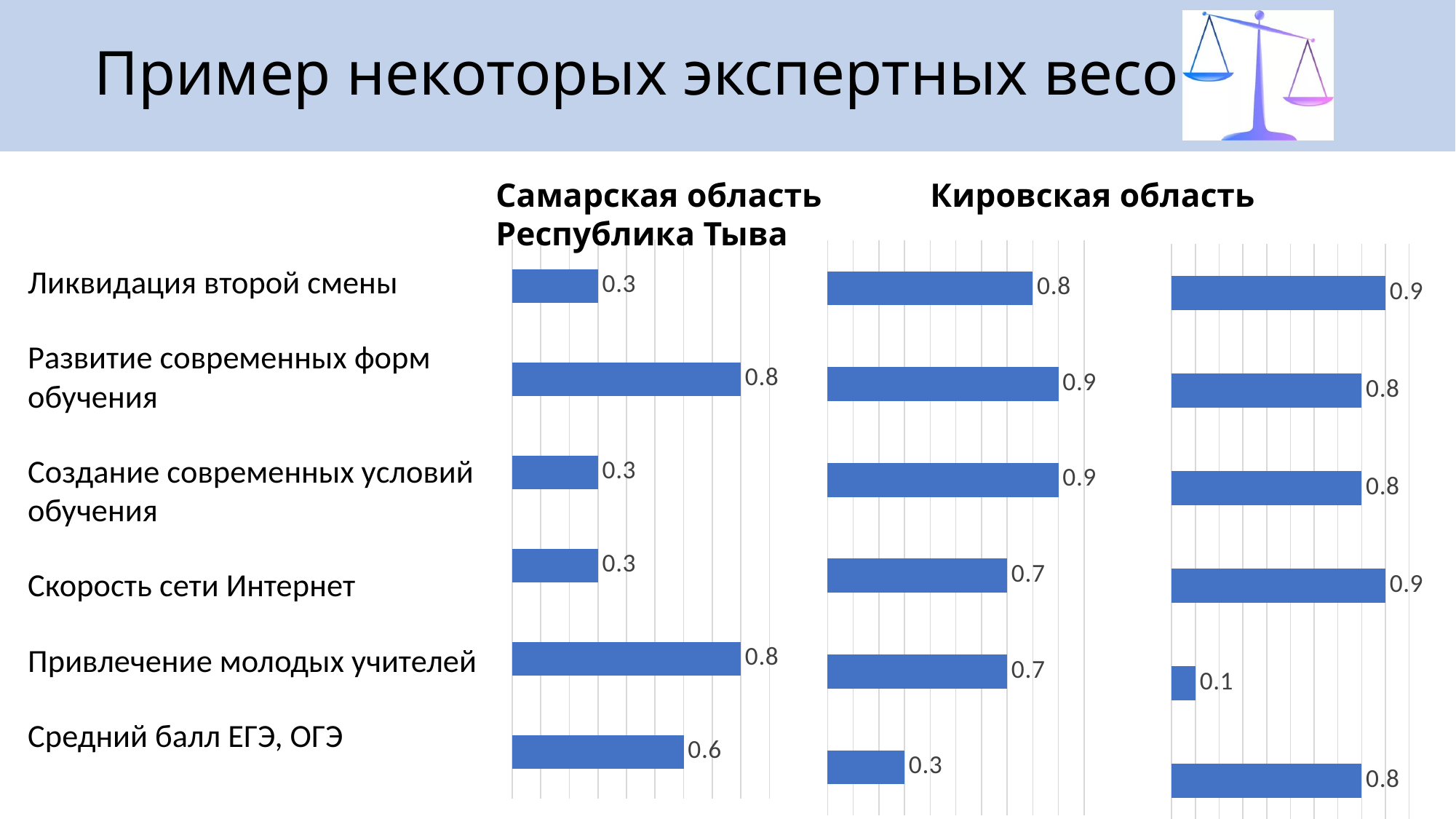
In the middle chart, which category has the lowest value? Средний балл ЕГЭ, ОГЭ How many categories are plotted in the left chart? 6 In the middle chart, what is the difference between the values for Ликвидация второй смены and Средний балл ЕГЭ, ОГЭ? 0.5 What is the heading printed above the middle chart? Кировская область In the right chart, what is the value for Привлечение молодых учителей? 0.1 What type of chart is the middle chart? bar chart In the left chart, what is the value for Ликвидация второй смены? 0.3 In the right chart, which category has the lowest value? Привлечение молодых учителей In the middle chart, what is the value for Скорость сети Интернет? 0.7 For Скорость сети Интернет, which chart shows the larger value, the left chart or the right chart? the right chart In the middle chart, what is the value for Средний балл ЕГЭ, ОГЭ? 0.3 In the left chart, what is the difference between the values for Привлечение молодых учителей and Средний балл ЕГЭ, ОГЭ? 0.2